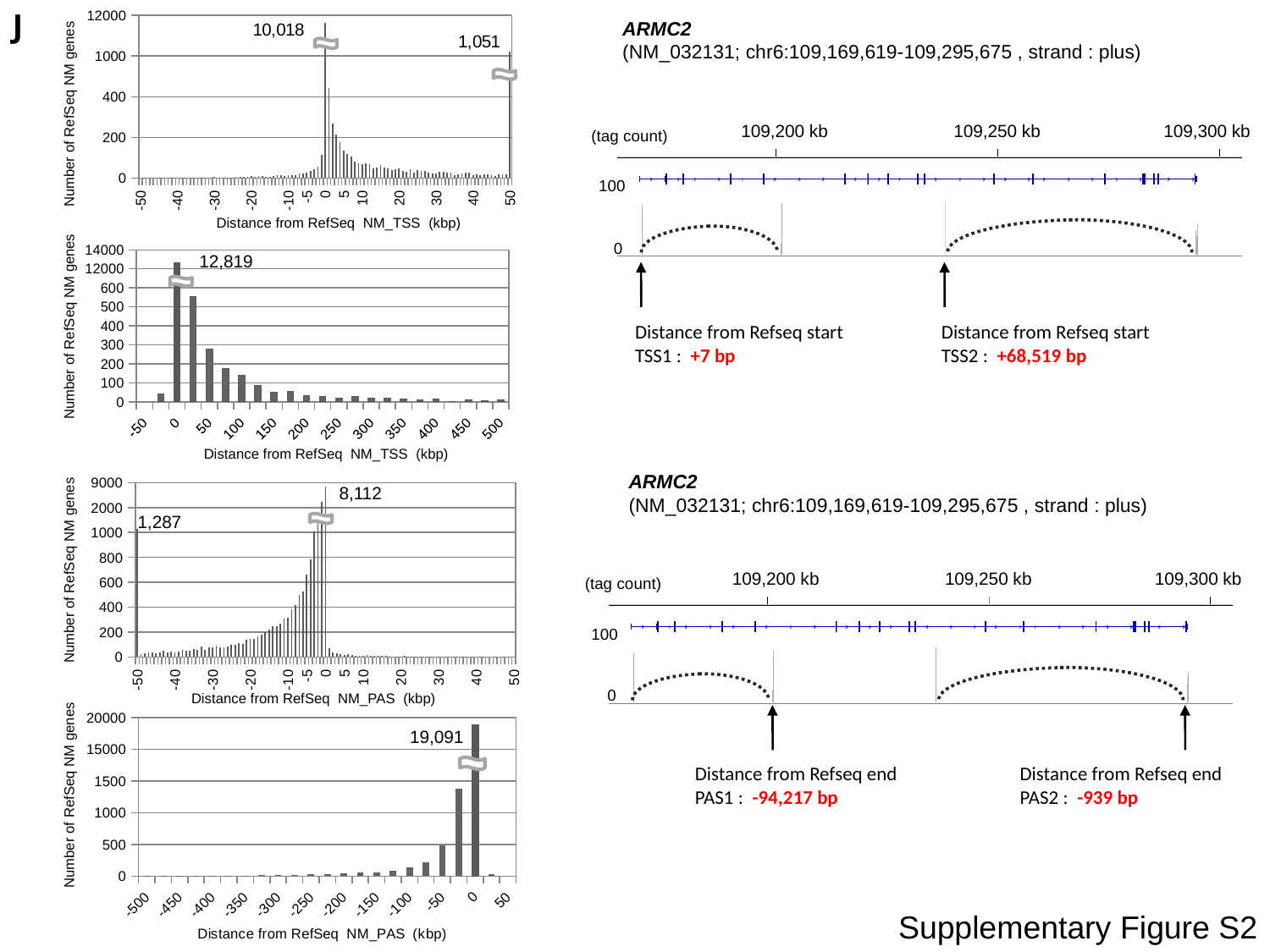
In the third chart from the top (Distance from RefSeq NM_PAS, -50 to 50 kbp), what value is printed on the tallest bar near 0 kbp? 8,112 In the second chart from the top (Distance from RefSeq NM_TSS, -50 to 500 kbp), what value is printed on the tallest bar? 12,819 In the third chart from the top (Distance from RefSeq NM_PAS, -50 to 50 kbp), what value is printed on the bar at -50 kbp? 1,287 In the top-left chart (Distance from RefSeq NM_TSS, -50 to 50 kbp), what value is printed on the tallest bar near 0 kbp? 10,018 In the third chart from the top (Distance from RefSeq NM_PAS, -50 to 50 kbp), which labelled value is larger, the one at -50 kbp or the one near 0 kbp? the one near 0 kbp (8,112) In the bottom-left chart (Distance from RefSeq NM_PAS, -500 to 50 kbp), is the value of the bar at -50 kbp greater or less than 1000? less In the bottom-left chart (Distance from RefSeq NM_PAS, -500 to 50 kbp), what value is printed on the tallest bar? 19,091 In the second chart from the top (Distance from RefSeq NM_TSS, -50 to 500 kbp), do the bar heights generally rise or fall as distance increases from 0 to 500 kbp? fall In the top-left chart (Distance from RefSeq NM_TSS, -50 to 50 kbp), what value is printed on the bar at 50 kbp? 1,051 In the top-left chart (Distance from RefSeq NM_TSS, -50 to 50 kbp), what is the difference between the two labelled values, 10,018 and 1,051? 8,967 What kind of chart is the bottom-left chart (Distance from RefSeq NM_PAS, -500 to 50 kbp)? bar chart What is the y-axis title of the top-left chart? Number of RefSeq NM genes